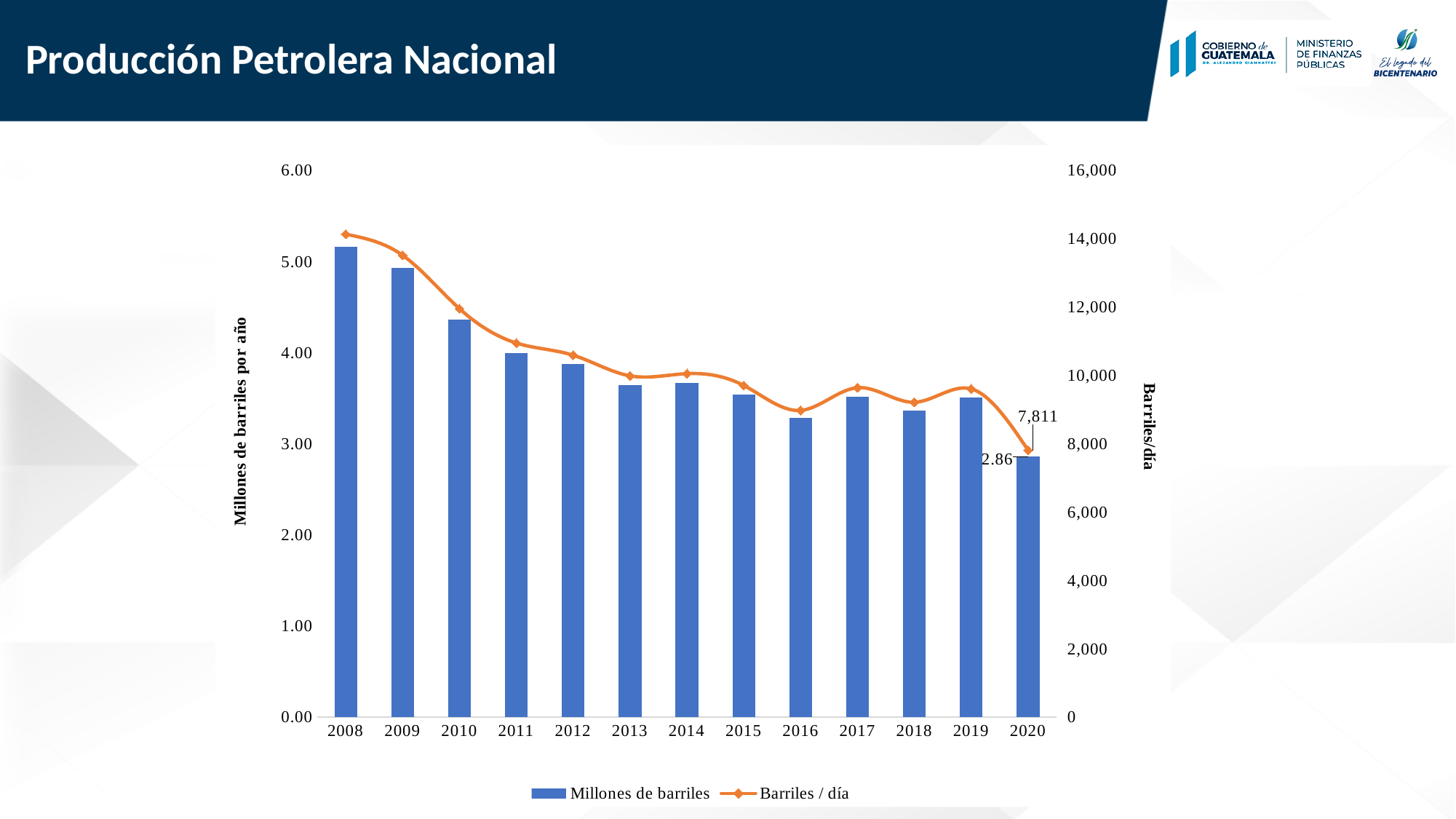
How many years are shown on the x axis of the chart? 13 How many series does the chart legend list? 2 What is the value of the Millones de barriles bar for 2020? 2.86 What is the Barriles / día value shown for 2020? 7,811 In which year is the Barriles / día line at its highest point? 2008 Is the Barriles / día value for 2016 greater or less than 10,000? less What is the overall trend of the Barriles / día line from 2008 to 2020? It falls Is the Millones de barriles value for 2008 greater or less than 5.00? greater Which year has the larger Millones de barriles bar, 2009 or 2012? 2009 Which year has the lowest Millones de barriles bar? 2020 Is the Millones de barriles value for 2016 greater or less than 4.00? less Which year has the highest Millones de barriles bar? 2008